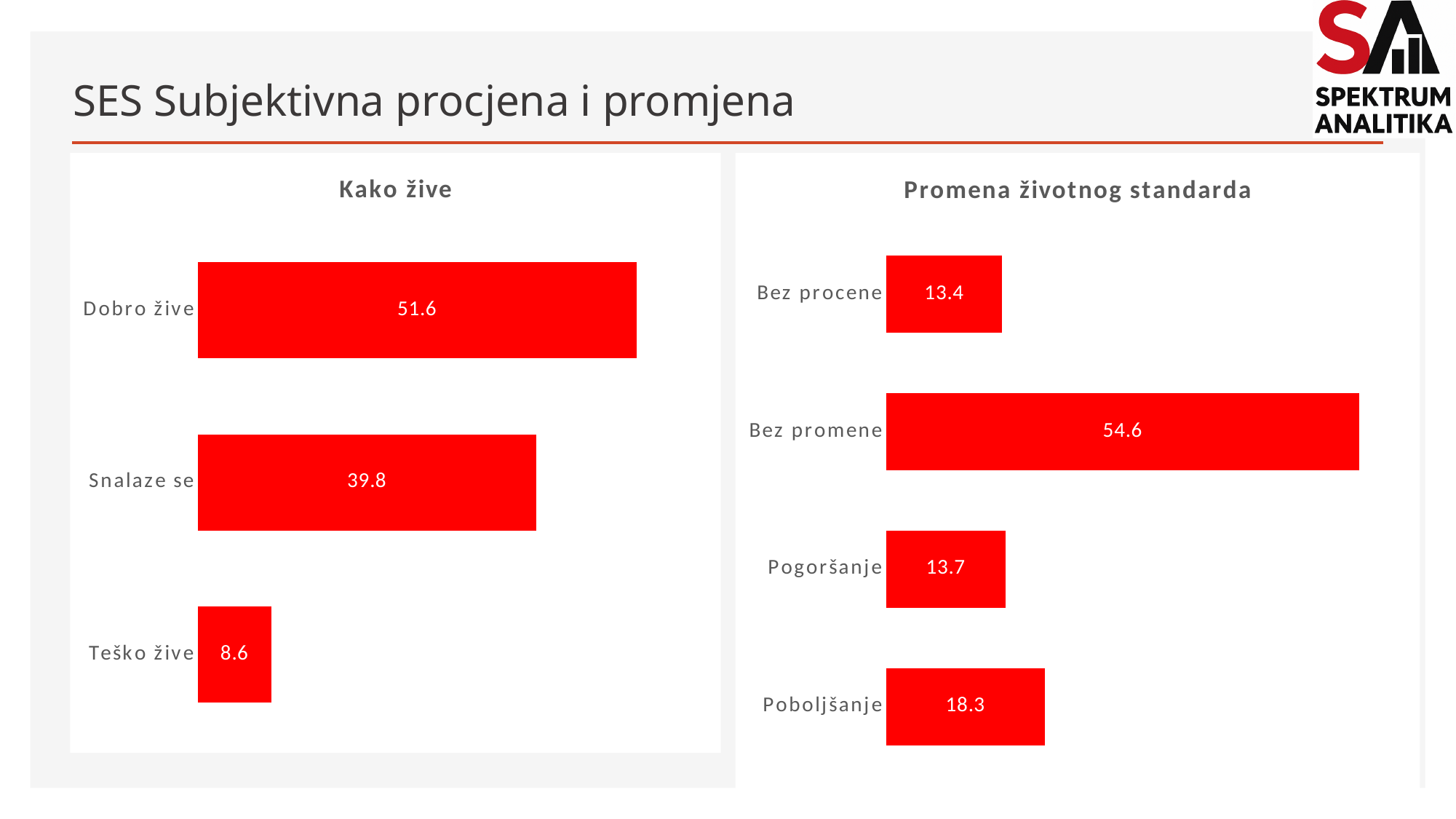
In the 'Promena životnog standarda' chart, which category has the highest value? Bez promene In the 'Promena životnog standarda' chart, what is the difference between Bez promene and Poboljšanje? 36.3 In the 'Promena životnog standarda' chart, how many categories are shown? 4 In the 'Kako žive' chart, how many categories are shown? 3 What type of chart is the 'Kako žive' chart? Bar chart In the 'Kako žive' chart, what is the value for Dobro žive? 51.6 In the 'Promena životnog standarda' chart, what is the value for Bez promene? 54.6 In the 'Promena životnog standarda' chart, which is larger, Poboljšanje or Pogoršanje? Poboljšanje In the 'Kako žive' chart, what is the difference between Dobro žive and Snalaze se? 11.8 In the 'Kako žive' chart, which category has the lowest value? Teško žive In the 'Promena životnog standarda' chart, what is the value for Poboljšanje? 18.3 In the 'Kako žive' chart, what is the value for Teško žive? 8.6